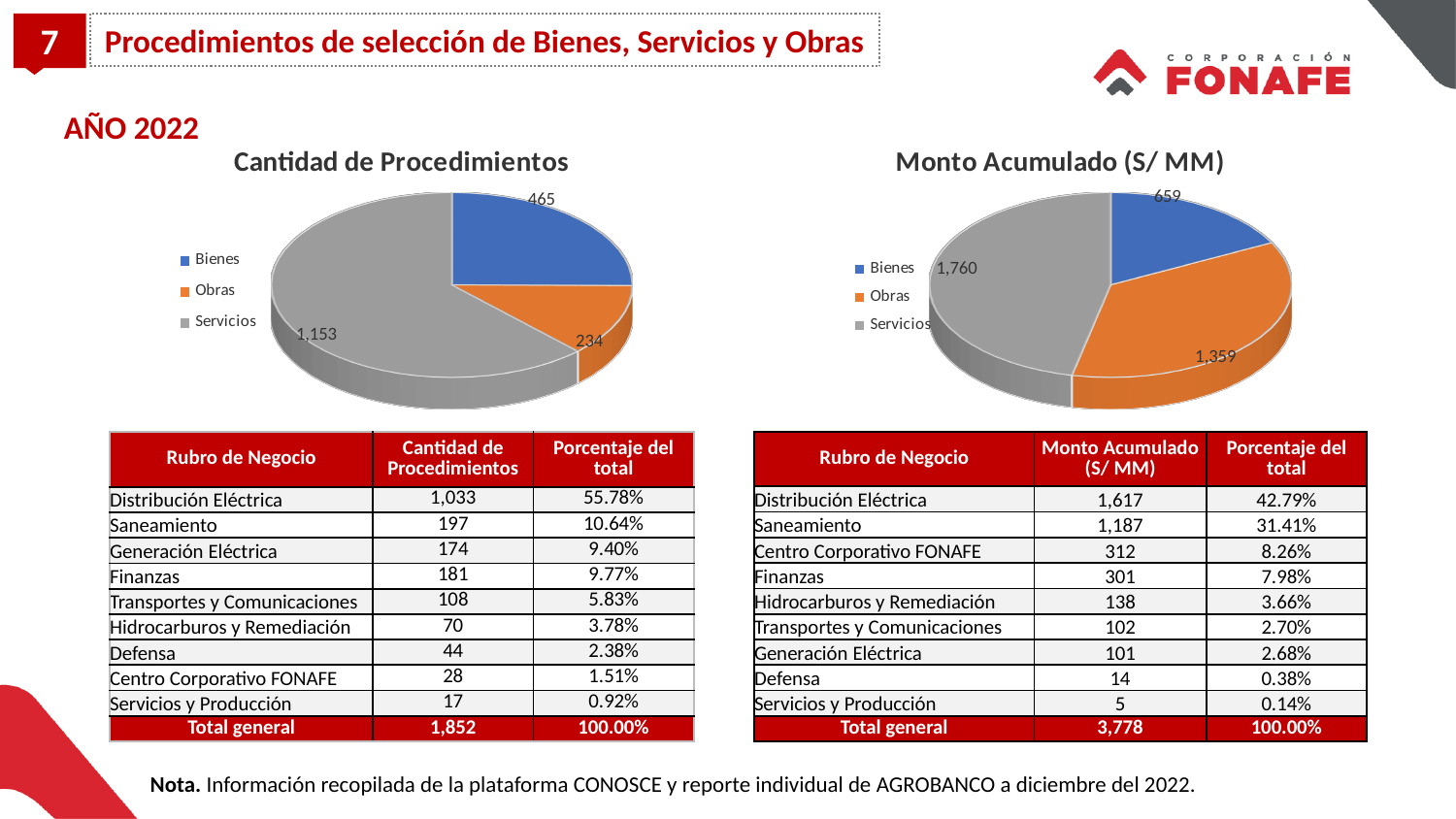
What type of chart is 'Cantidad de Procedimientos'? Pie chart In the 'Cantidad de Procedimientos' chart, what is the value for Servicios? 1,153 In the 'Monto Acumulado (S/ MM)' chart, what is the total of all three slices? 3,778 In the 'Monto Acumulado (S/ MM)' chart, which category has the smallest value? Bienes In the 'Cantidad de Procedimientos' chart, which category has the largest slice? Servicios How many categories does the 'Monto Acumulado (S/ MM)' chart show? 3 In the 'Cantidad de Procedimientos' chart, what is the value for Obras? 234 In the 'Cantidad de Procedimientos' chart, what is the difference between the values for Bienes and Obras? 231 In the 'Monto Acumulado (S/ MM)' chart, what is the value for Bienes? 659 In the 'Monto Acumulado (S/ MM)' chart, which is larger, Obras or Bienes? Obras In the 'Cantidad de Procedimientos' chart, which category has the smallest slice? Obras In the 'Monto Acumulado (S/ MM)' chart, what is the value for Obras? 1,359